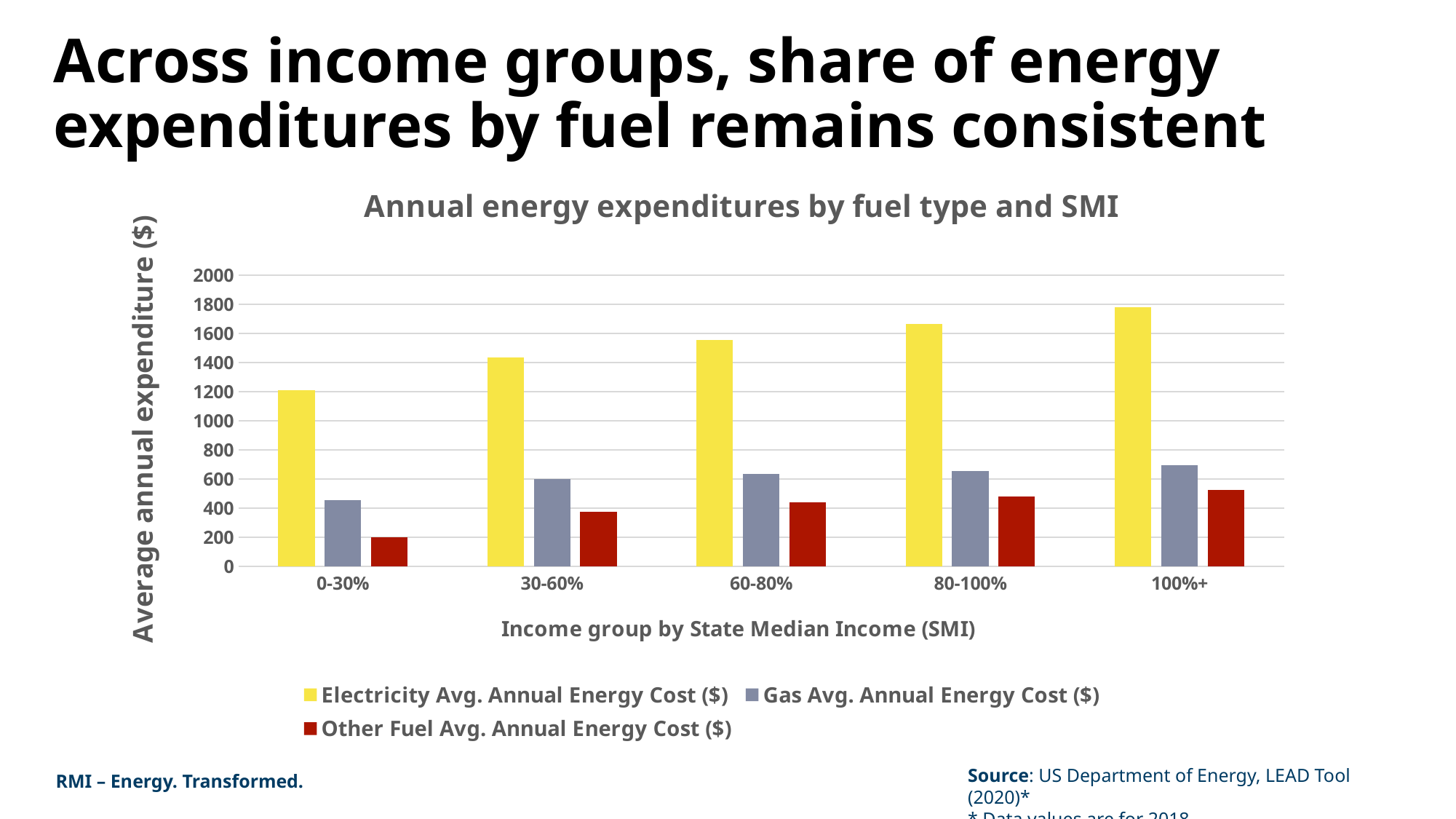
Do the Electricity Avg. Annual Energy Cost values rise or fall as income group increases along the x axis? rise What is the title of the chart? Annual energy expenditures by fuel type and SMI What kind of chart is shown on the slide? bar chart Which is larger for the 60-80% group: the Gas Avg. Annual Energy Cost or the Other Fuel Avg. Annual Energy Cost? Gas Avg. Annual Energy Cost ($) Which income group has the lowest Other Fuel Avg. Annual Energy Cost? 0-30% Is the Electricity Avg. Annual Energy Cost for the 0-30% group greater or less than 1000? greater How many income groups are shown on the x axis? 5 Is the Other Fuel Avg. Annual Energy Cost for the 0-30% group greater or less than 400? less How many series does the legend list? 3 Which income group has the highest Electricity Avg. Annual Energy Cost? 100%+ Is the Electricity Avg. Annual Energy Cost for the 100%+ group greater or less than 1600? greater